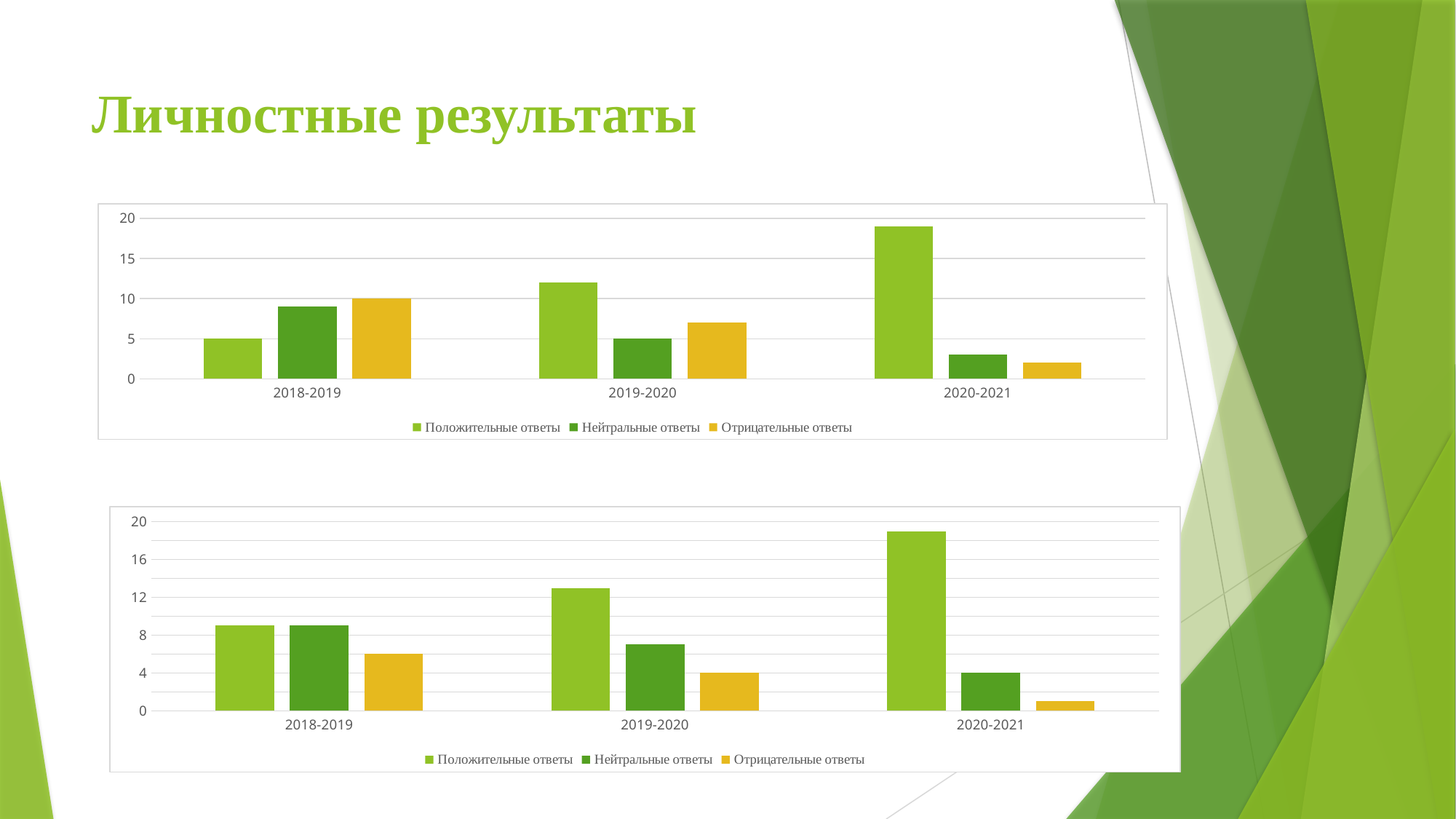
In the bottom chart, do the values for Положительные ответы rise or fall from 2018-2019 to 2020-2021? rise In the top chart, is the value of Положительные ответы for 2020-2021 greater or less than 15? greater What type of chart is the top chart on the slide? bar chart In the top chart, which category has the lowest value for Отрицательные ответы? 2020-2021 In the top chart, what is the value of Нейтральные ответы for 2019-2020? 5 How many categories are shown on the x axis of the top chart? 3 In the bottom chart, what is the value of Отрицательные ответы for 2019-2020? 4 In the bottom chart, what is the value of Нейтральные ответы for 2020-2021? 4 In the bottom chart, which category has the highest value for Положительные ответы? 2020-2021 In the top chart, what is the value of Отрицательные ответы for 2018-2019? 10 In the top chart, what is the value of Положительные ответы for 2018-2019? 5 How many series does the legend of the bottom chart list? 3